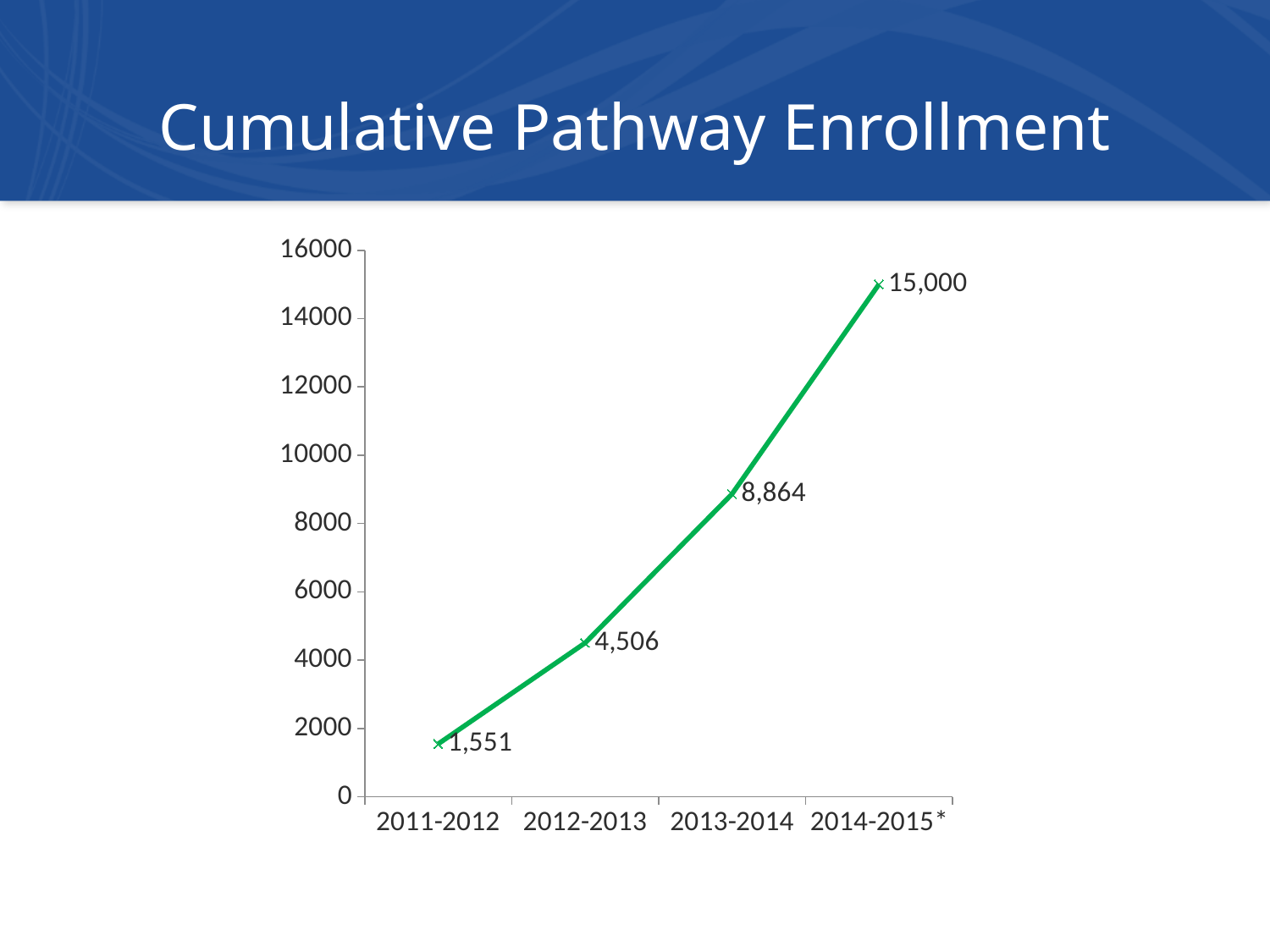
What is the cumulative pathway enrollment for 2013-2014? 8,864 Which year has the highest cumulative pathway enrollment? 2014-2015* What is the cumulative pathway enrollment for 2012-2013? 4,506 What is the cumulative pathway enrollment for 2011-2012? 1,551 Is the enrollment for 2013-2014 greater or less than 10000? less What is the difference in enrollment between 2014-2015* and 2013-2014? 6,136 What is the difference in enrollment between 2013-2014 and 2012-2013? 4,358 What is the cumulative pathway enrollment for 2014-2015*? 15,000 What kind of chart is shown on the slide? Line chart How many data points are plotted on the chart? 4 Which year has the lowest cumulative pathway enrollment? 2011-2012 Does cumulative pathway enrollment rise or fall from 2011-2012 to 2014-2015*? Rises